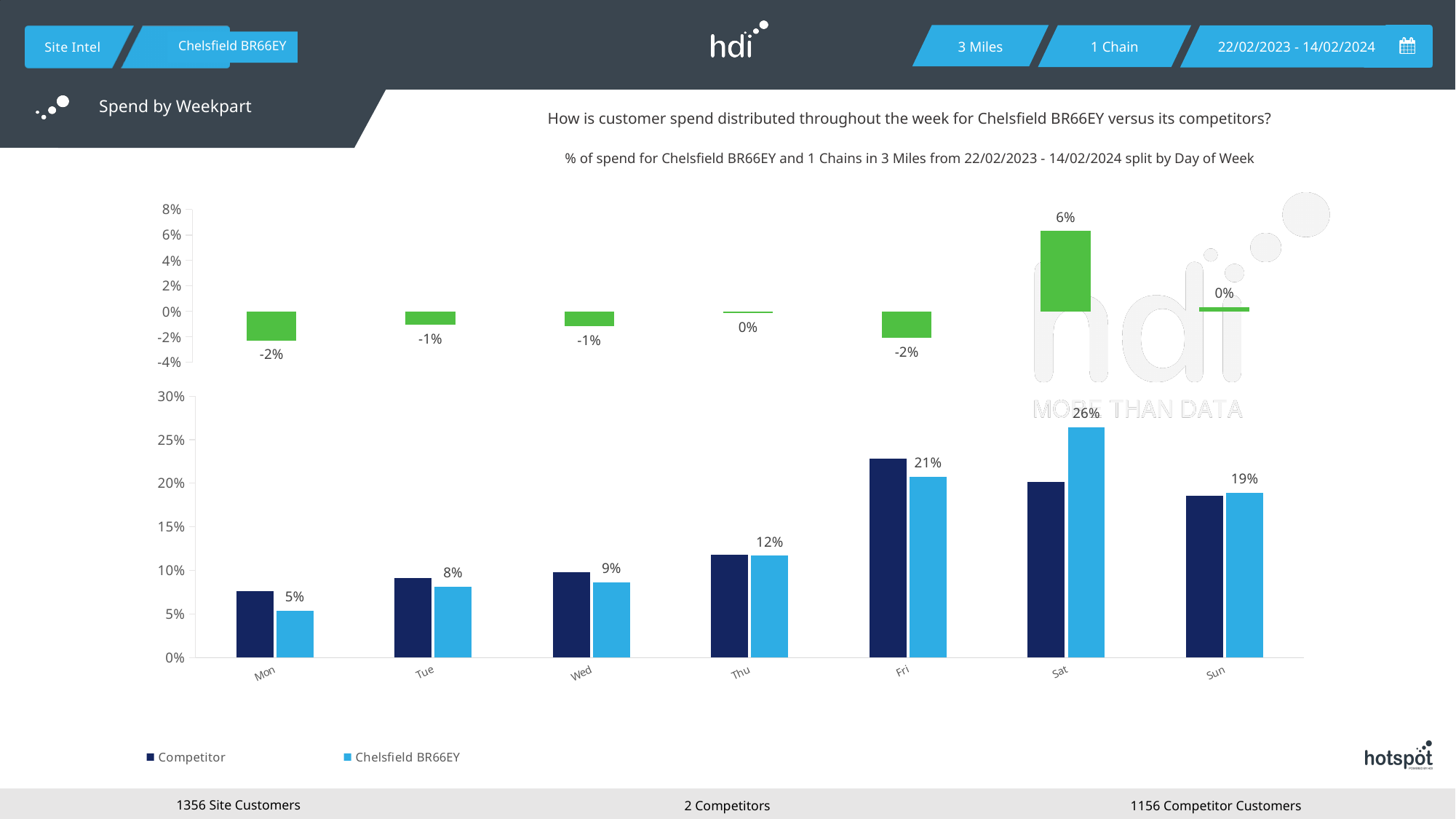
In the bottom chart, is the Competitor value for Mon greater or less than 10%? less In the bottom chart, what is the value for Chelsfield BR66EY on Sat? 26% How many days of the week are shown on the x axis of the bottom chart? 7 How many series does the legend of the bottom chart list? 2 What kind of chart is the bottom chart? Bar chart In the bottom chart, on Fri, which is larger: the Competitor bar or the Chelsfield BR66EY bar? Competitor In the bottom chart, on which day is the Chelsfield BR66EY value highest? Sat In the bottom chart, is the Competitor value for Fri greater or less than 20%? greater In the bottom chart, what is the difference between the Chelsfield BR66EY values for Sat and Sun? 7% In the bottom chart, on which day is the Chelsfield BR66EY value lowest? Mon In the top chart (green bars), which day has the highest value? Sat In the top chart (green bars), what is the value shown for Sat? 6%